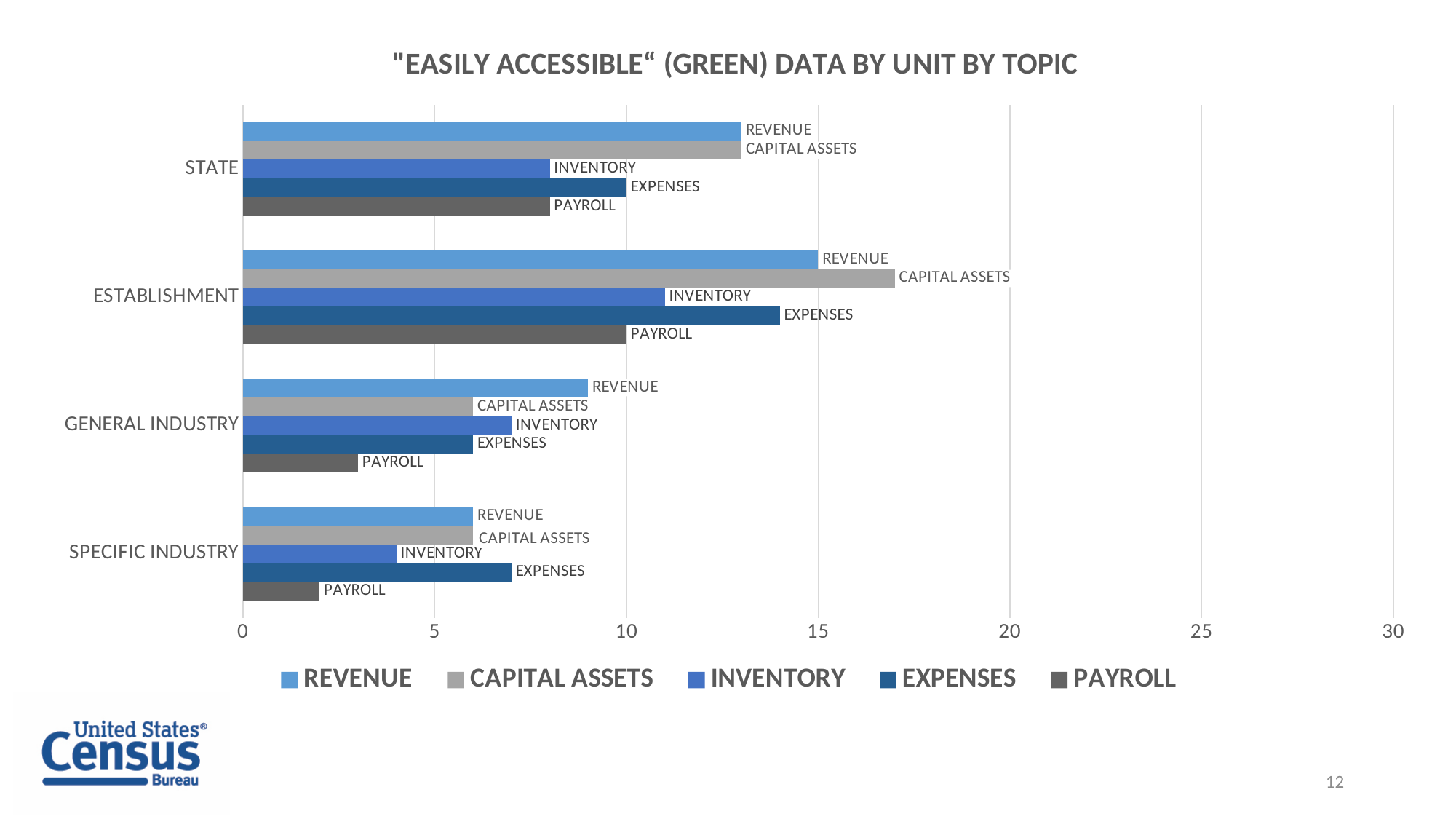
How many series does the legend list? 5 What is the value of REVENUE for ESTABLISHMENT? 15 How many unit categories are shown on the vertical axis? 4 What is the title of the chart? "EASILY ACCESSIBLE" (GREEN) DATA BY UNIT BY TOPIC Which unit has the highest CAPITAL ASSETS value? ESTABLISHMENT For GENERAL INDUSTRY, which is larger: REVENUE or PAYROLL? REVENUE What is the value of EXPENSES for STATE? 10 Is the value of PAYROLL for SPECIFIC INDUSTRY greater or less than 5? less What kind of chart is shown on the slide? bar chart Within SPECIFIC INDUSTRY, which topic has the lowest value? PAYROLL Is the value of CAPITAL ASSETS for ESTABLISHMENT greater or less than 15? greater What is the value of PAYROLL for ESTABLISHMENT? 10